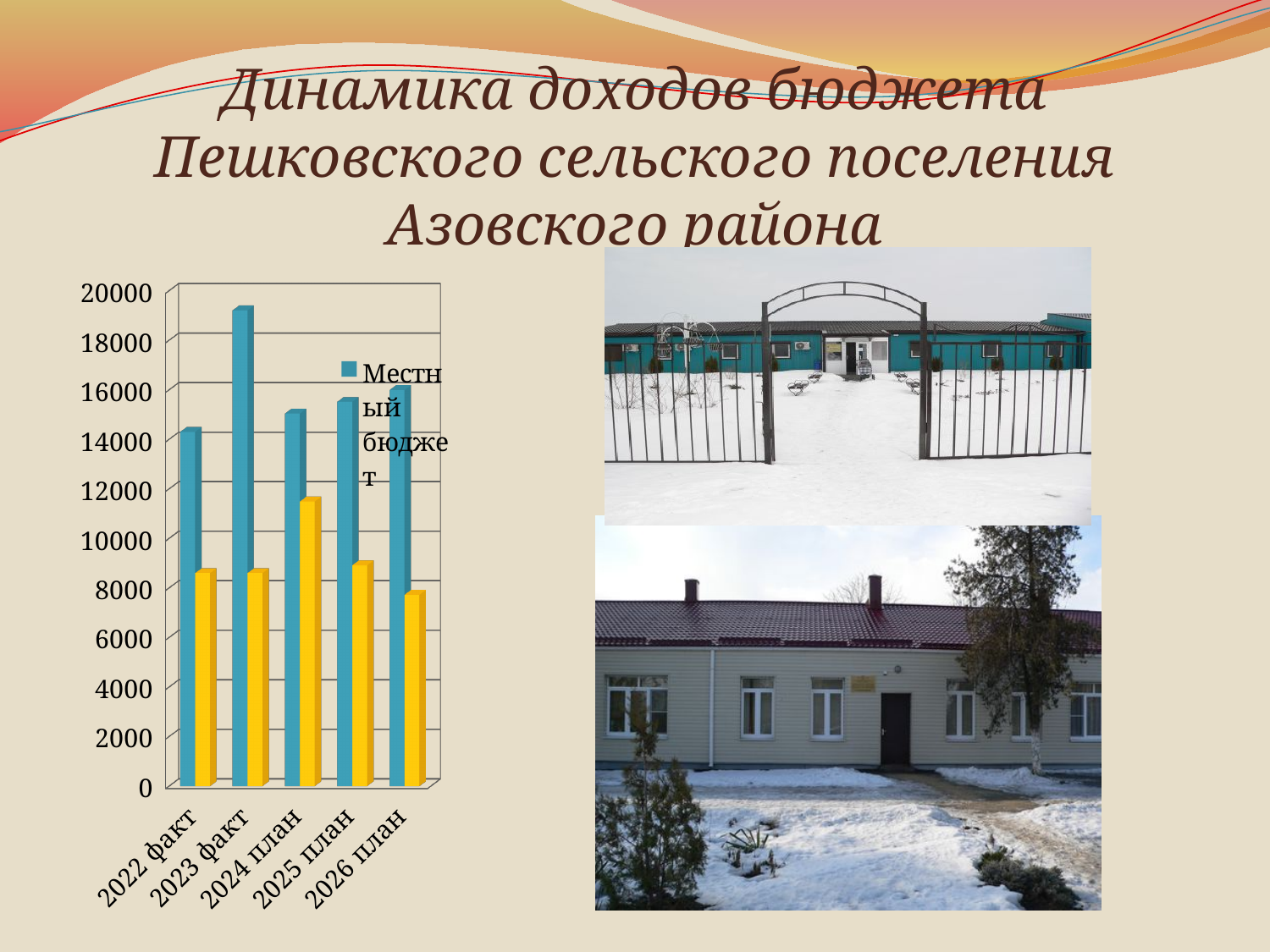
For the blue series (Местный бюджет), which is larger: 2023 факт or 2024 план? 2023 факт Which category has the lowest value for the yellow series? 2026 план Which category has the highest value for the blue series (Местный бюджет)? 2023 факт Is the value of the yellow series for 2024 план greater or less than 10000? greater How many categories are shown on the x axis of the chart? 5 What legend entry is shown next to the chart? Местный бюджет Is the value of the blue series (Местный бюджет) for 2026 план greater or less than 18000? less Which category has the lowest value for the blue series (Местный бюджет)? 2022 факт What kind of chart is shown on the slide? bar chart Which category has the highest value for the yellow series? 2024 план Is the value of the blue series (Местный бюджет) for 2023 факт greater or less than 18000? greater